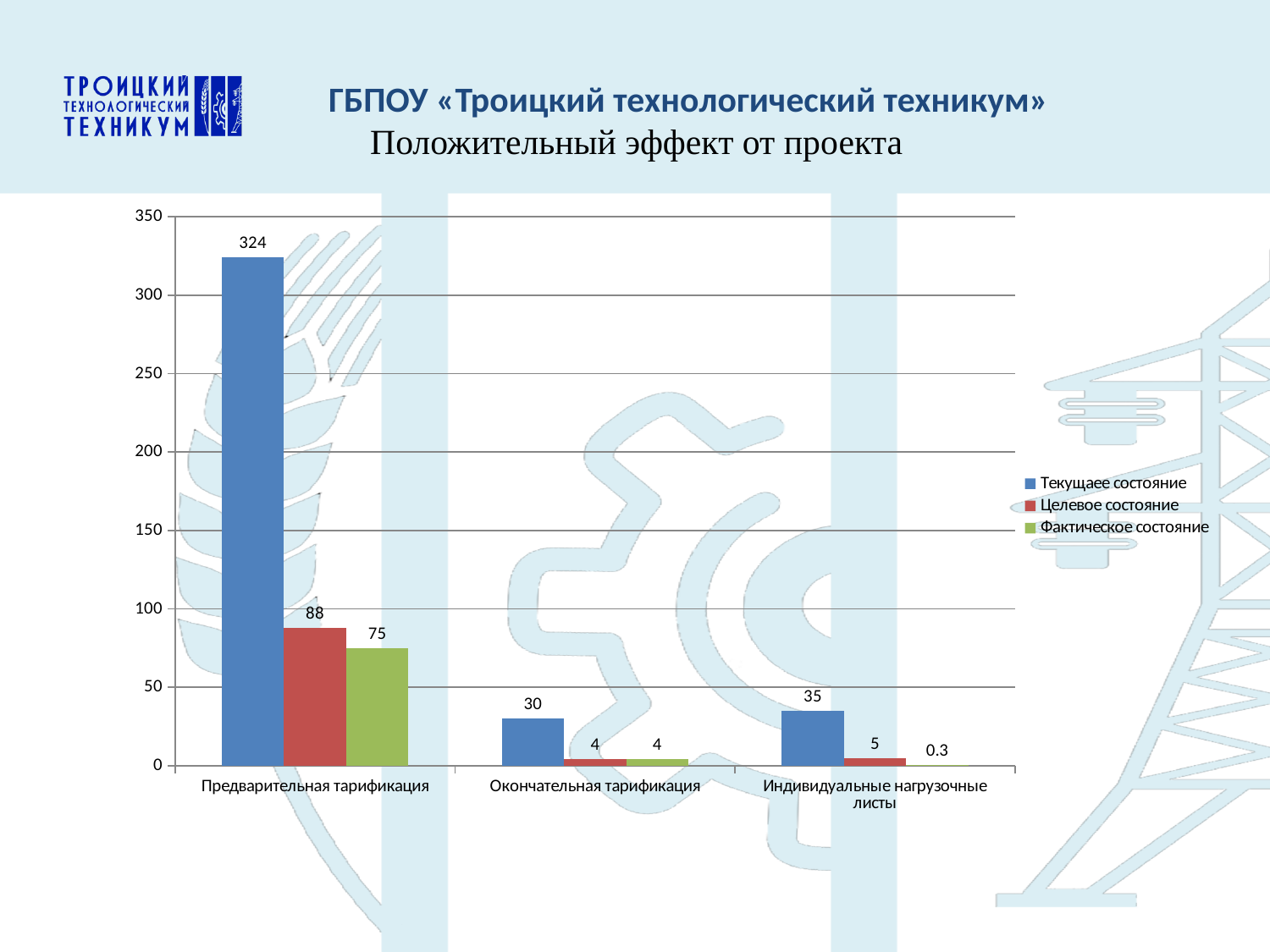
Which category has the lowest Фактическое состояние value? Индивидуальные нагрузочные листы Which category has the highest Текущаее состояние value? Предварительная тарификация What is the difference between Текущаее состояние and Фактическое состояние for Предварительная тарификация? 249 What is the value of Текущаее состояние for Предварительная тарификация? 324 How many series does the legend list? 3 Which is larger for Индивидуальные нагрузочные листы: Текущаее состояние or Целевое состояние? Текущаее состояние Is the Текущаее состояние value for Предварительная тарификация greater or less than 300? greater How many categories are shown on the x axis? 3 What kind of chart is shown on the slide? bar chart What is the value of Текущаее состояние for Окончательная тарификация? 30 What is the value of Целевое состояние for Предварительная тарификация? 88 What is the value of Фактическое состояние for Индивидуальные нагрузочные листы? 0.3